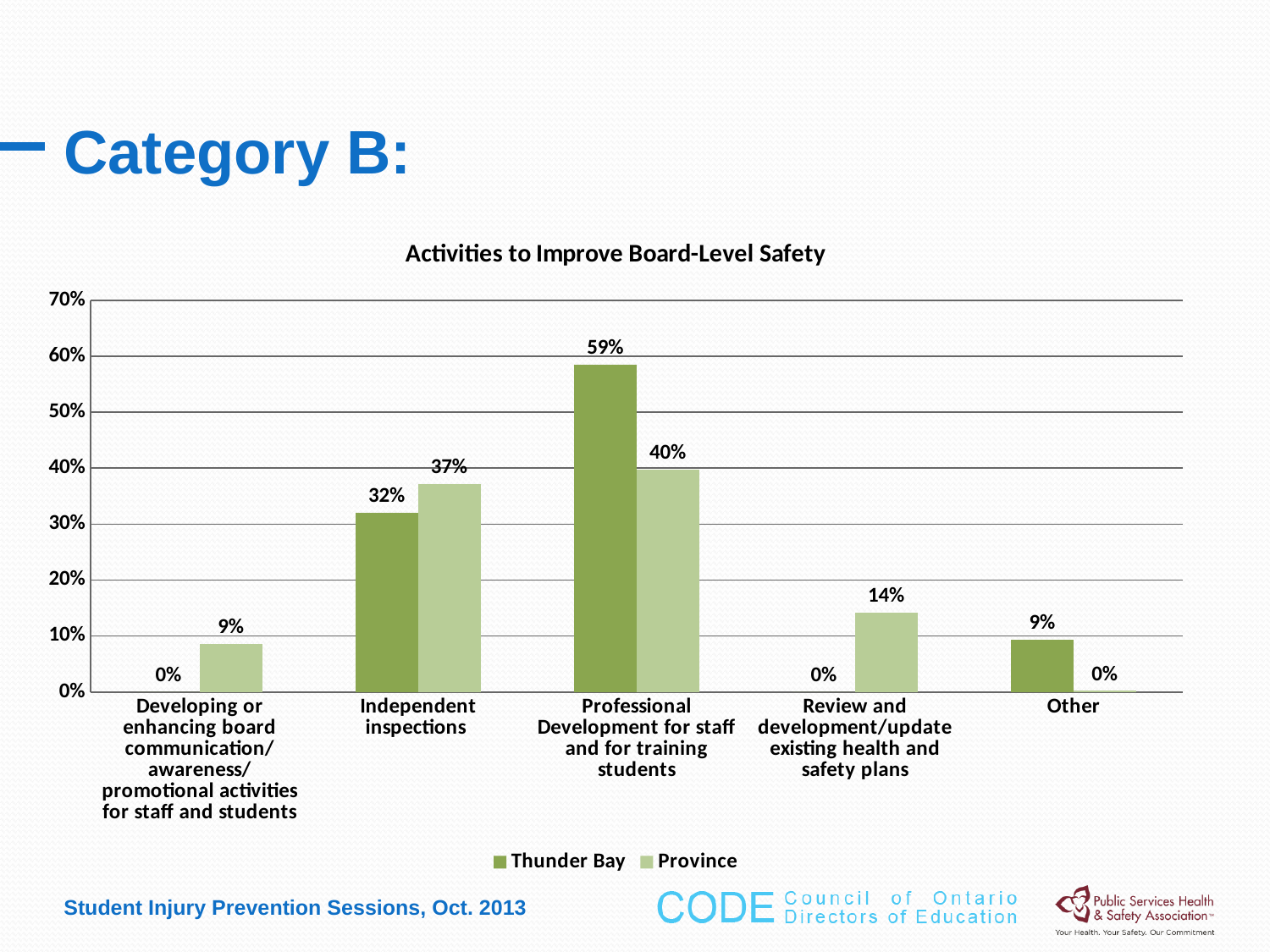
What is the Province value for Review and development/update existing health and safety plans? 14% What is the Province value for Independent inspections? 37% What is the difference between the Thunder Bay and Province values for Professional Development for staff and for training students? 19% What is the Thunder Bay value for Other? 9% How many series does the legend list? 2 How many categories are shown on the x axis? 5 Which category has the highest Thunder Bay value? Professional Development for staff and for training students Is the Province value for Professional Development for staff and for training students greater or less than 50%? less What is the Thunder Bay value for Professional Development for staff and for training students? 59% Which category has the lowest Province value? Other What type of chart is shown? bar chart Which is larger for Independent inspections, the Thunder Bay value or the Province value? Province